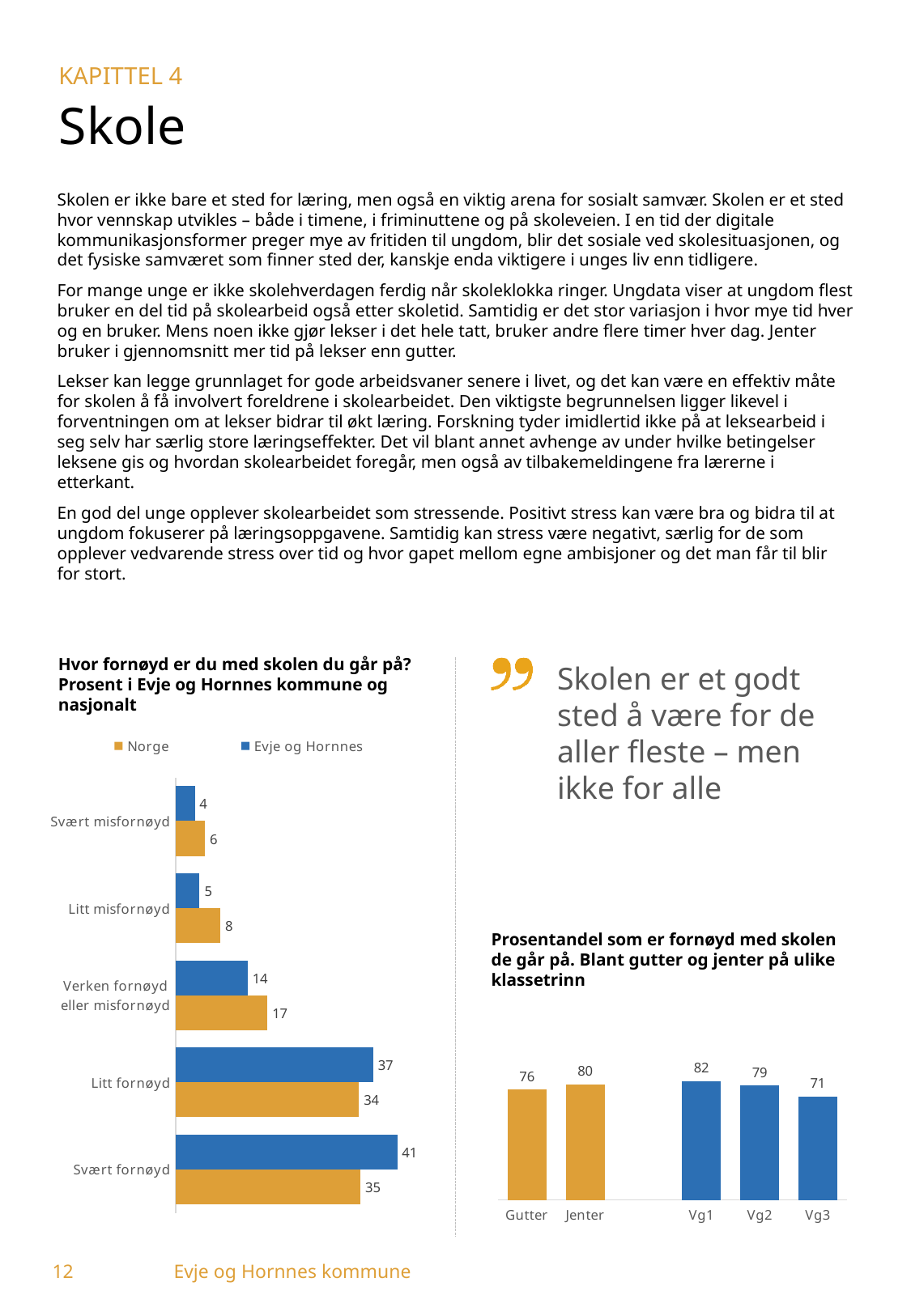
How many series does the legend of the chart 'Hvor fornøyd er du med skolen du går på?' list? 2 In the chart 'Prosentandel som er fornøyd med skolen de går på', what is the value for Jenter? 80 What kind of chart is 'Prosentandel som er fornøyd med skolen de går på'? Bar chart In the chart 'Prosentandel som er fornøyd med skolen de går på', which category has the lowest value? Vg3 In the chart 'Hvor fornøyd er du med skolen du går på?', what is the value for Norge in the category 'Litt misfornøyd'? 8 In the chart 'Hvor fornøyd er du med skolen du går på?', which category has the lowest value for Norge? Svært misfornøyd In the chart 'Prosentandel som er fornøyd med skolen de går på', do the values rise or fall from Vg1 to Vg3? Fall In the chart 'Hvor fornøyd er du med skolen du går på?', what is the value for Evje og Hornnes in the category 'Svært fornøyd'? 41 In the chart 'Hvor fornøyd er du med skolen du går på?', which is larger for 'Verken fornøyd eller misfornøyd': Norge or Evje og Hornnes? Norge How many categories are shown in the chart 'Hvor fornøyd er du med skolen du går på?'? 5 In the chart 'Hvor fornøyd er du med skolen du går på?', which category has the highest value for Evje og Hornnes? Svært fornøyd In the chart 'Hvor fornøyd er du med skolen du går på?', what is the difference between Evje og Hornnes and Norge for 'Svært fornøyd'? 6